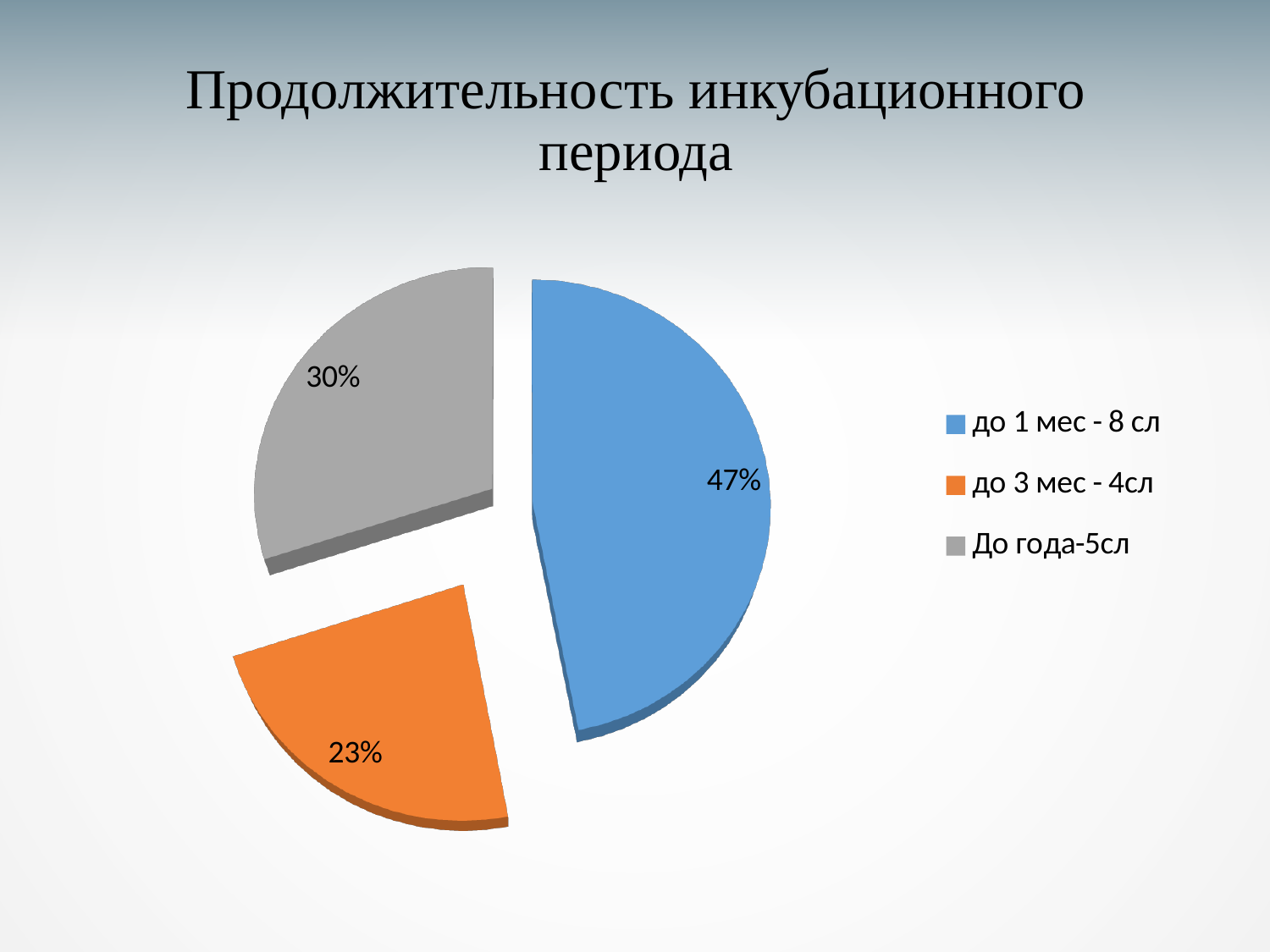
How many slices does the pie chart have? 3 What kind of chart is shown on the slide? pie chart What is the title of the chart on the slide? Продолжительность инкубационного периода What percentage is shown for the slice 'до 3 мес - 4сл'? 23% What is the difference in percentage points between the 'до 1 мес - 8 сл' slice and the 'до 3 мес - 4сл' slice? 24 Which is larger: the share for 'До года-5сл' or the share for 'до 3 мес - 4сл'? До года-5сл Which slice has the smallest share of the pie? до 3 мес - 4сл What percentage is shown for the slice 'До года-5сл'? 30% What percentage is shown for the slice 'до 1 мес - 8 сл'? 47% Which slice has the largest share of the pie? до 1 мес - 8 сл What is the difference in percentage points between the 'До года-5сл' slice and the 'до 3 мес - 4сл' slice? 7 What colour is the slice for 'до 3 мес - 4сл'? orange